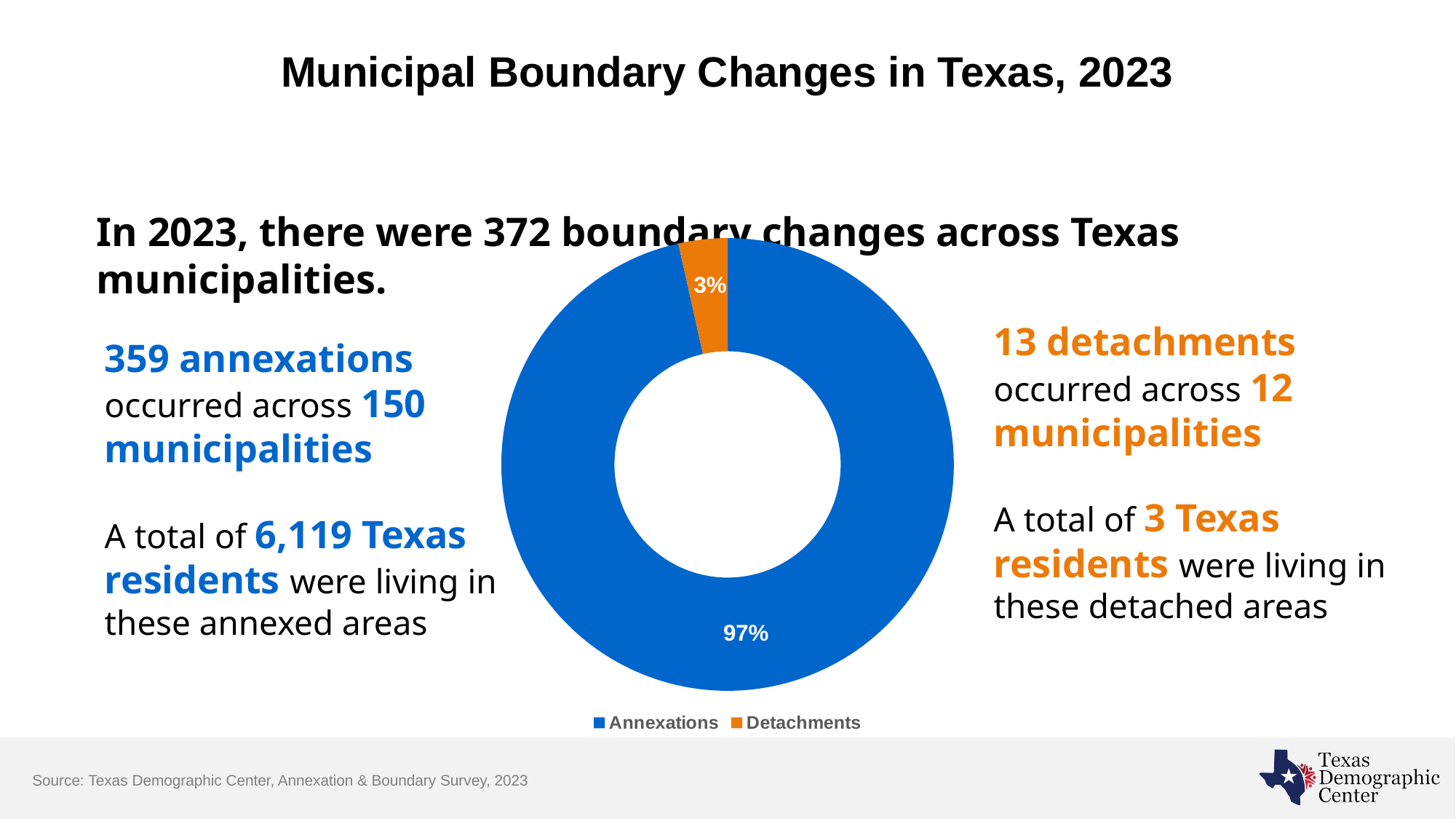
Is the share for Annexations greater or less than 50%? greater What share of the chart do Detachments make up? 3% Which is larger, the share for Annexations or the share for Detachments? Annexations Which category has the largest share of the chart? Annexations Which category has the smallest share of the chart? Detachments How many entries does the legend list? 2 What colour represents Annexations in the chart? Blue What is the difference in percentage points between the Annexations share and the Detachments share? 94 percentage points What kind of chart is shown on the slide? Doughnut (pie) chart How many categories does the chart show? 2 What share of the chart do Annexations make up? 97% What colour represents Detachments in the chart? Orange